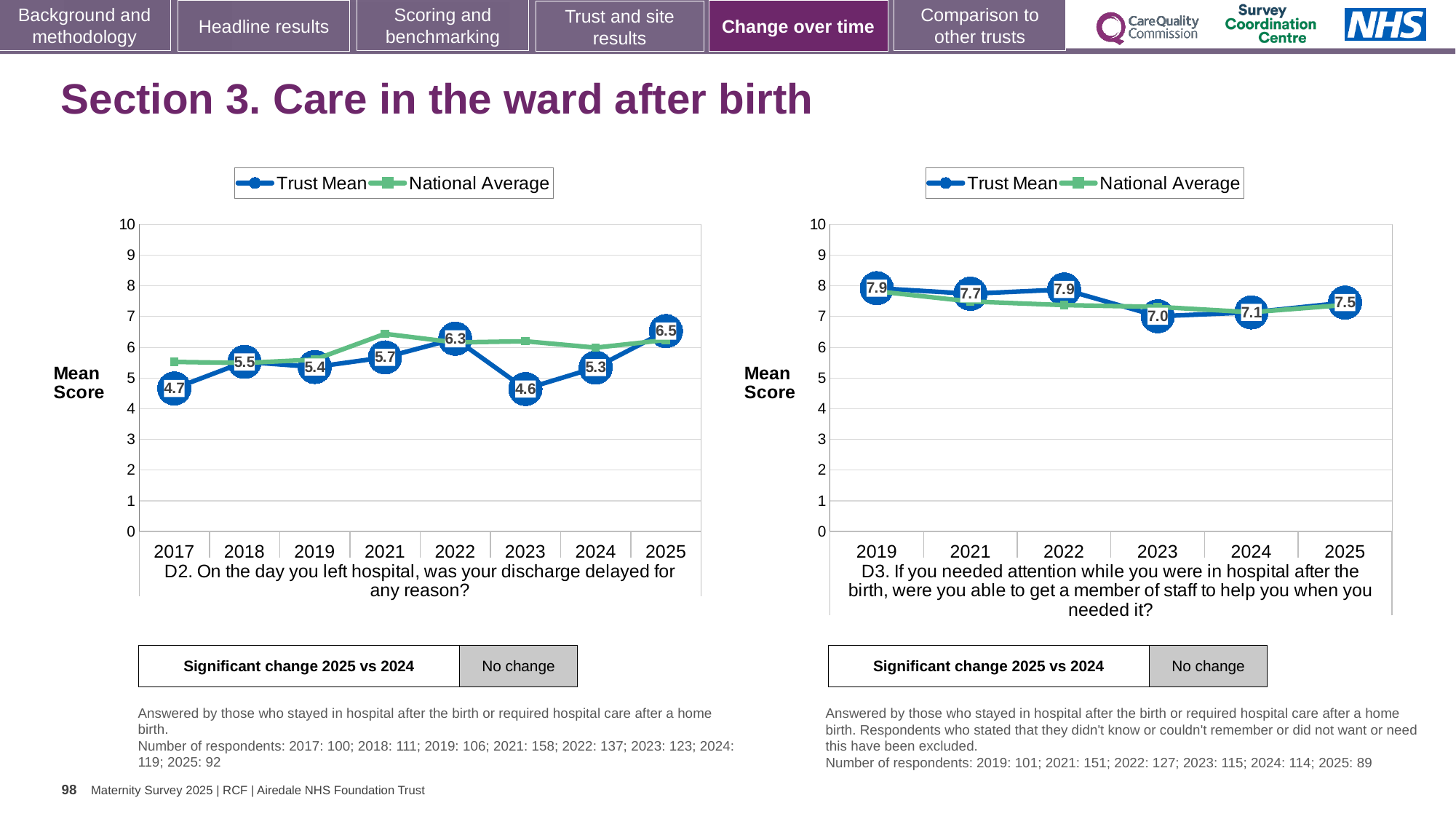
How many series does the legend of the D3 chart (right) list? 2 In the D2 chart (left), how many years are shown on the x axis? 8 In the D3 chart (right), what is the Trust Mean for 2023? 7.0 In the D2 chart (left), what is the difference between the Trust Mean for 2025 and 2024? 1.2 In the D3 chart (right), is the Trust Mean for 2021 larger or smaller than for 2024? larger In the D2 chart (left), what is the Trust Mean for 2017? 4.7 In the D2 chart (left), which year has the highest Trust Mean? 2025 In the D3 chart (right), is the National Average for 2019 greater or less than 7? greater In the D2 chart (left), what is the Trust Mean for 2023? 4.6 In the D3 chart (right), what is the Trust Mean for 2025? 7.5 In the D2 chart (left), which year has the lowest Trust Mean? 2023 In the D3 chart (right), which year has the lowest Trust Mean? 2023